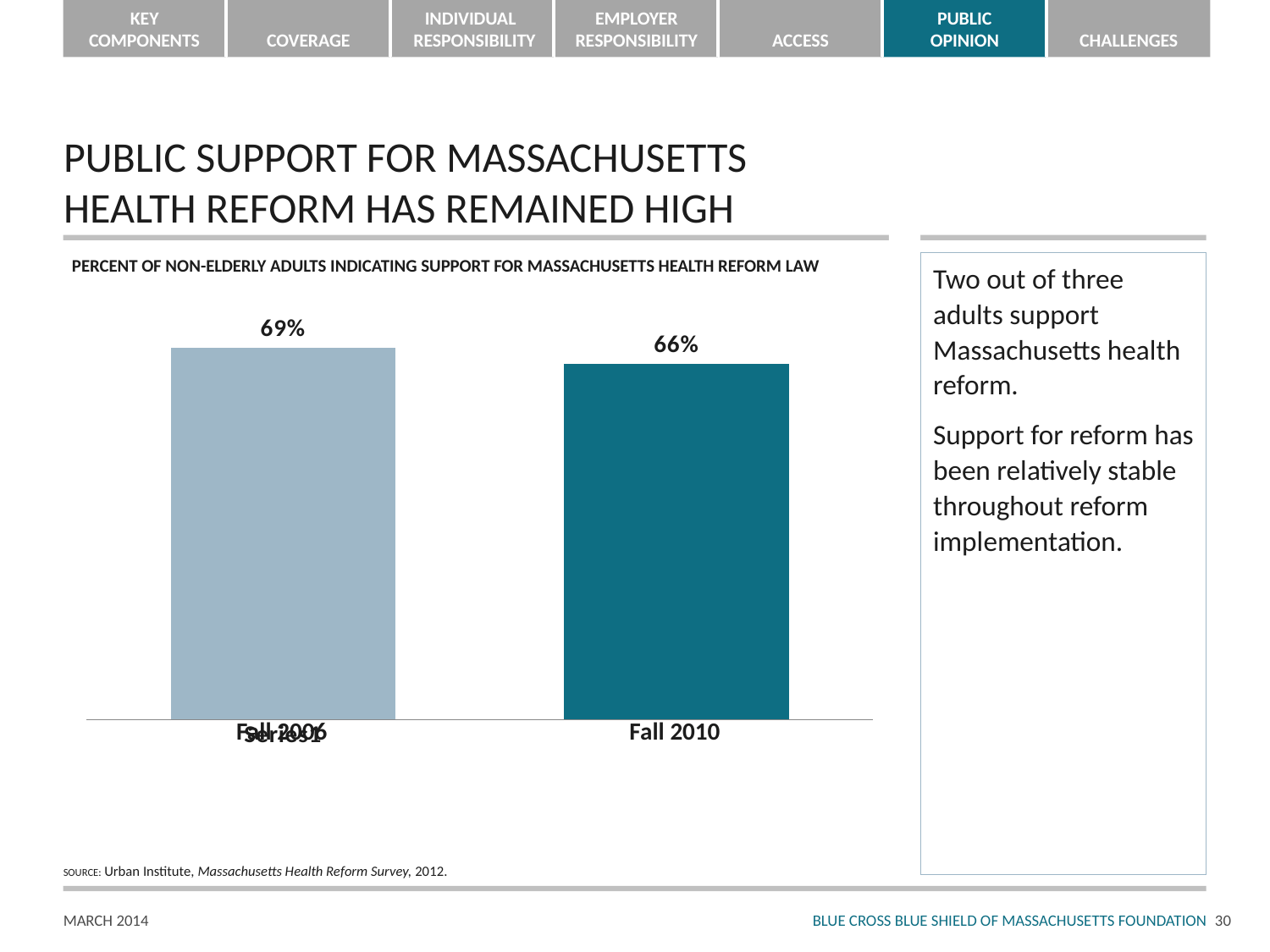
How many time periods are shown in the chart? 2 Which period has the highest percentage of support shown in the chart? Fall 2006 Which period has the lowest percentage of support shown in the chart? Fall 2010 By how many percentage points did support decline from Fall 2006 to Fall 2010? 3 percentage points Which period shows the higher level of support, Fall 2006 or Fall 2010? Fall 2006 What type of chart is used to show support for the Massachusetts health reform law? Bar chart What is the source of the data in the chart? Urban Institute, Massachusetts Health Reform Survey, 2012 What percentage of non-elderly adults indicated support for the Massachusetts health reform law in Fall 2006? 69% Does support for the health reform law rise or fall from Fall 2006 to Fall 2010? Fall What is the subtitle describing what the chart measures? Percent of non-elderly adults indicating support for Massachusetts health reform law What percentage of non-elderly adults indicated support for the Massachusetts health reform law in Fall 2010? 66%